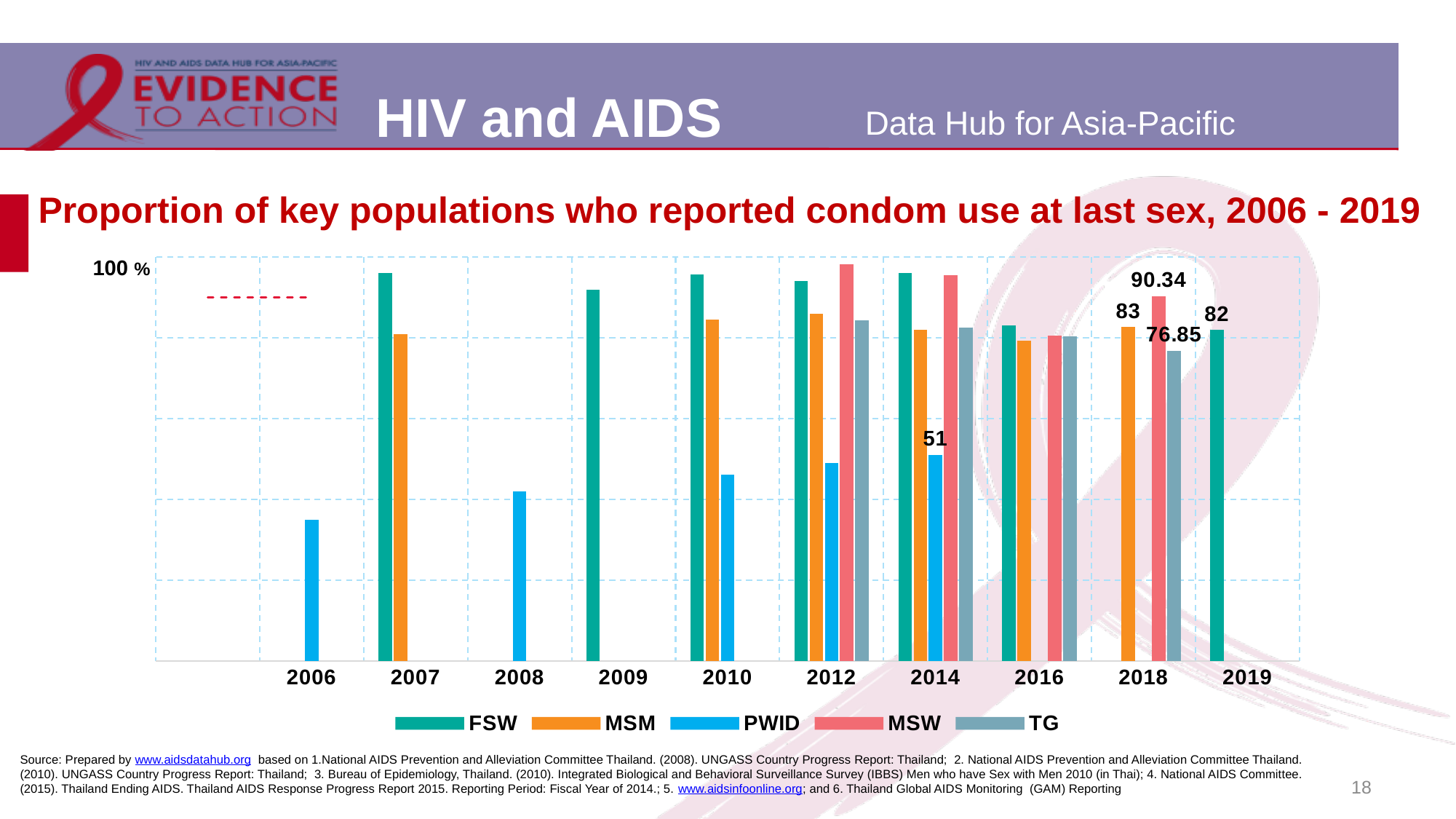
What type of chart is shown on the slide? bar chart What is the value for TG in 2018? 76.85 How many years are shown on the x axis? 10 How many series does the legend list? 5 What is the difference between the MSW value and the TG value in 2018? 13.49 Which is larger in 2014, the FSW value or the PWID value? FSW Which series is shown in blue in the legend? PWID What is the value for MSW in 2018? 90.34 Which series has the highest value in 2018? MSW What is the value for MSM in 2018? 83 What is the value for PWID in 2014? 51 What is the value for FSW in 2019? 82